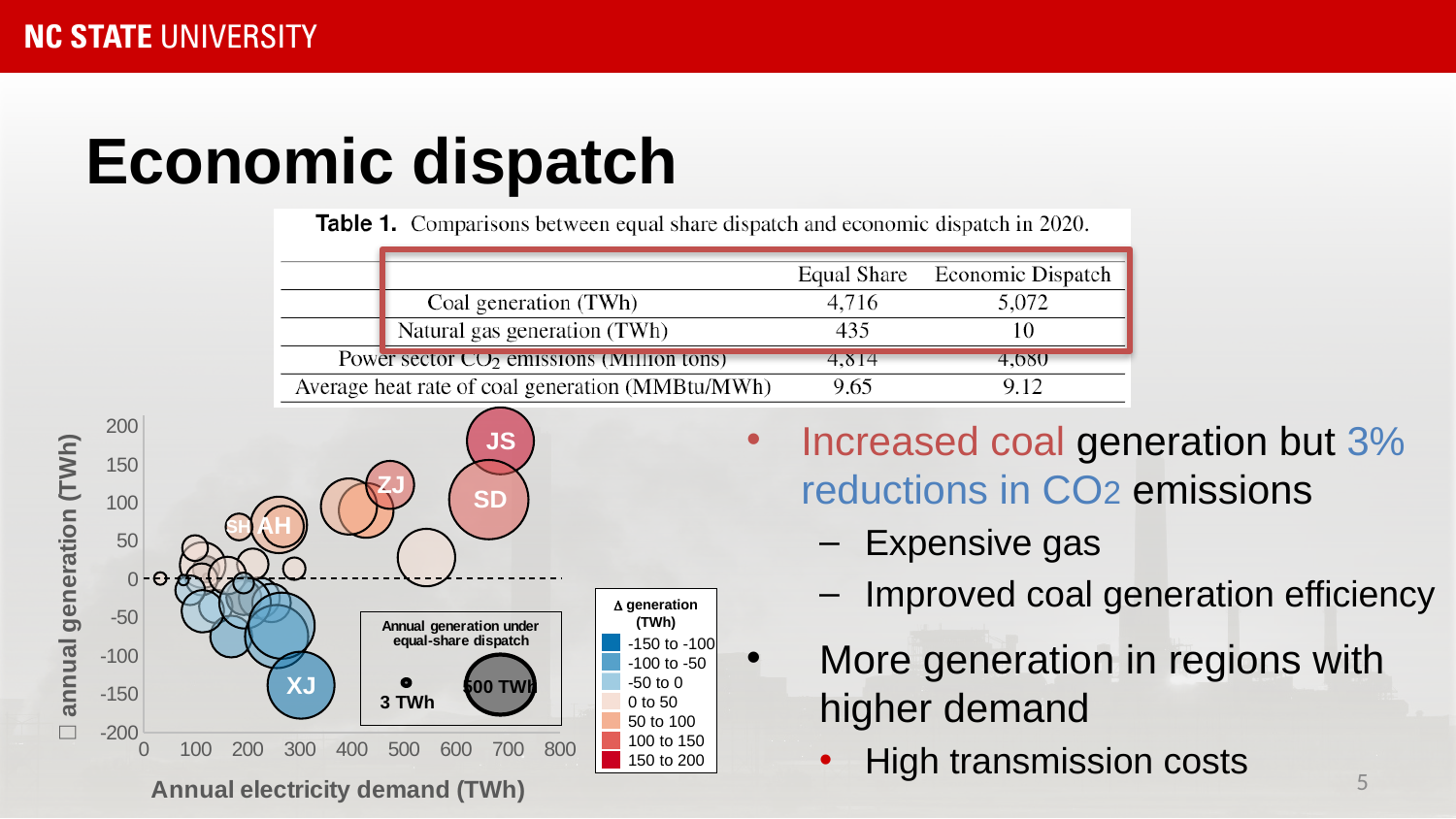
Is the Δ annual generation for SD greater or less than 0 TWh? greater What is the title of the colour legend of the bubble chart? Δ generation (TWh) Which has the larger annual electricity demand, JS or XJ? JS How many colour bins does the legend of the bubble chart list? 7 Which labelled region has the highest Δ annual generation in the bubble chart? JS Is the Δ annual generation for XJ greater or less than -100 TWh? less What is the title of the x axis of the bubble chart? Annual electricity demand (TWh) Which labelled region has the lowest Δ annual generation in the bubble chart? XJ Is the Δ annual generation for JS greater or less than 100 TWh? greater What kind of chart is shown on the slide? bubble chart Which has the larger Δ annual generation, JS or XJ? JS How many regions are labelled by name in the bubble chart? 6